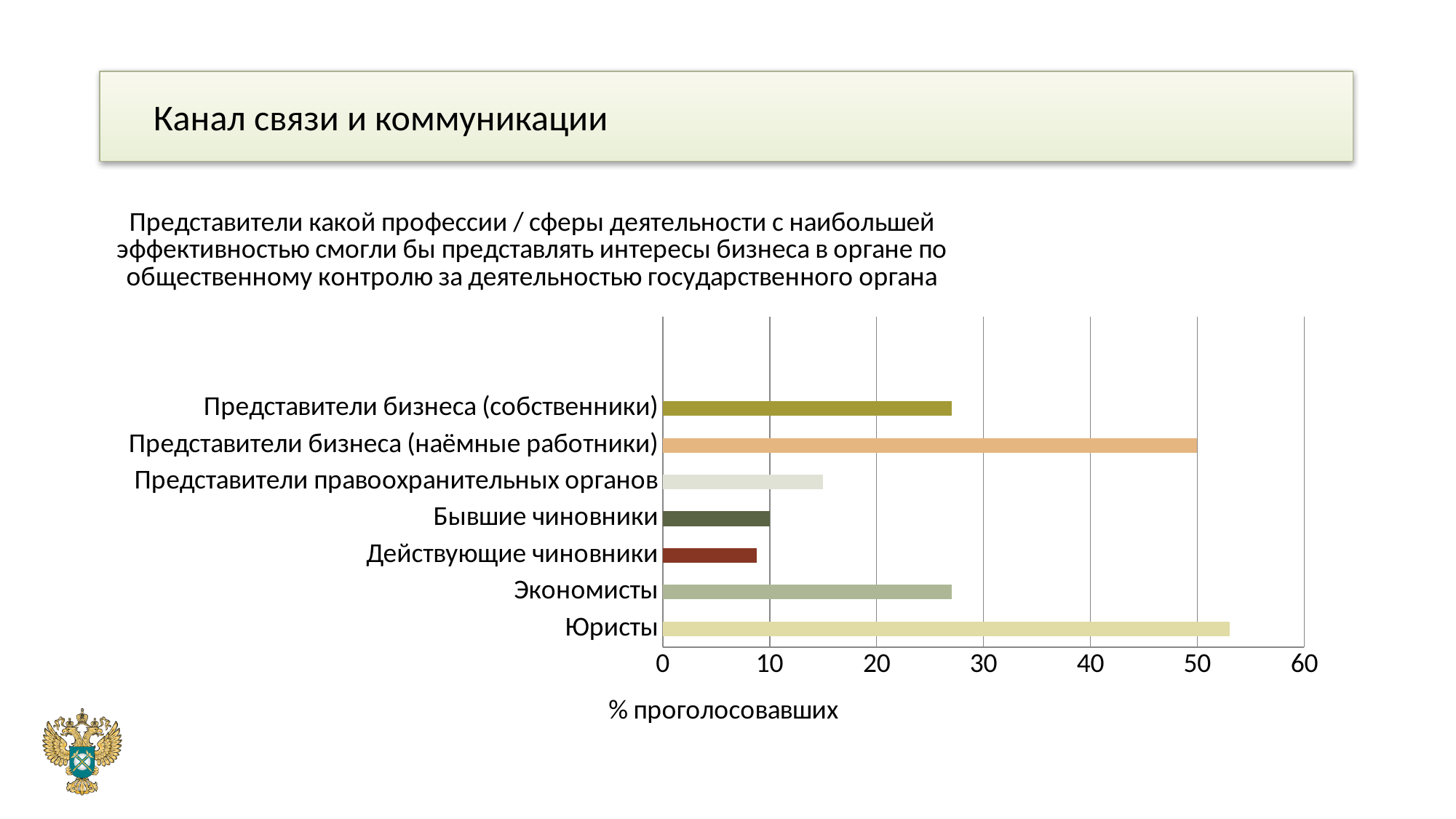
Is the value for Экономисты greater or less than 20? greater What is the label of the horizontal axis of the chart? % проголосовавших Which is larger, the value for Представители бизнеса (наёмные работники) or the value for Представители бизнеса (собственники)? Представители бизнеса (наёмные работники) How many categories (professions) are plotted in the chart? 7 Is the value for Юристы greater or less than 50? greater Which is larger, the value for Юристы or the value for Экономисты? Юристы What is the value for Представители бизнеса (наёмные работники)? 50 Is the value for Представители правоохранительных органов greater or less than 20? less Which category has the lowest value in the chart? Действующие чиновники Which category has the highest value in the chart? Юристы What kind of chart is shown on the slide? bar chart What is the value for Бывшие чиновники? 10